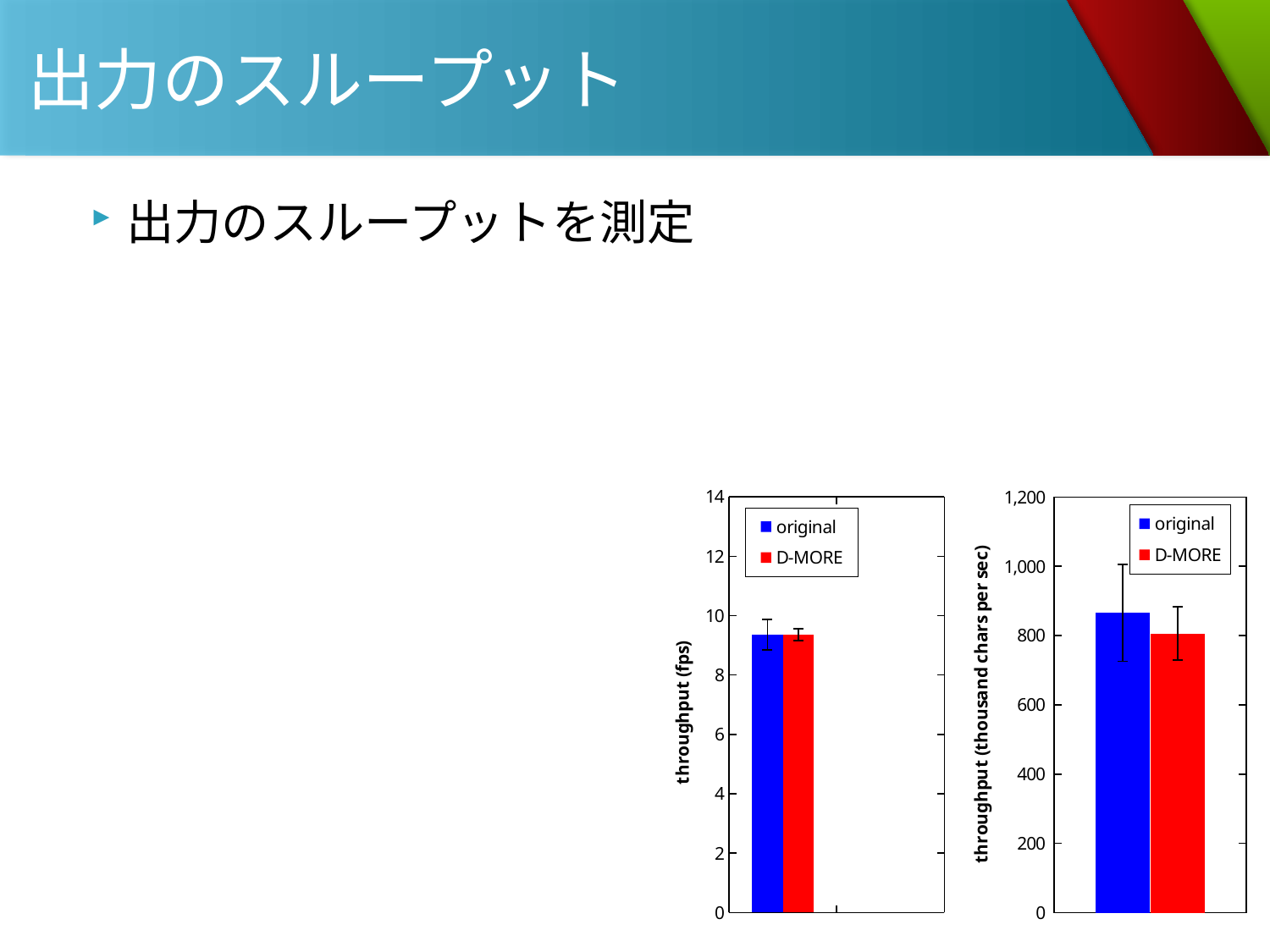
In the right chart (throughput in thousand chars per sec), is the value for D-MORE greater or less than 600? greater In the right chart (throughput in thousand chars per sec), which series has the higher bar, original or D-MORE? original In the left chart (throughput in fps), is the value for D-MORE greater or less than 10? less What kind of chart is the left chart (throughput in fps)? bar chart In the right chart (throughput in thousand chars per sec), is the value for D-MORE greater or less than 1,000? less How many series does the legend of the right chart (throughput in thousand chars per sec) list? 2 What is the y-axis label of the right chart? throughput (thousand chars per sec) How many series does the legend of the left chart (throughput in fps) list? 2 In the left chart (throughput in fps), which series is shown in blue? original What kind of chart is the right chart (throughput in thousand chars per sec)? bar chart